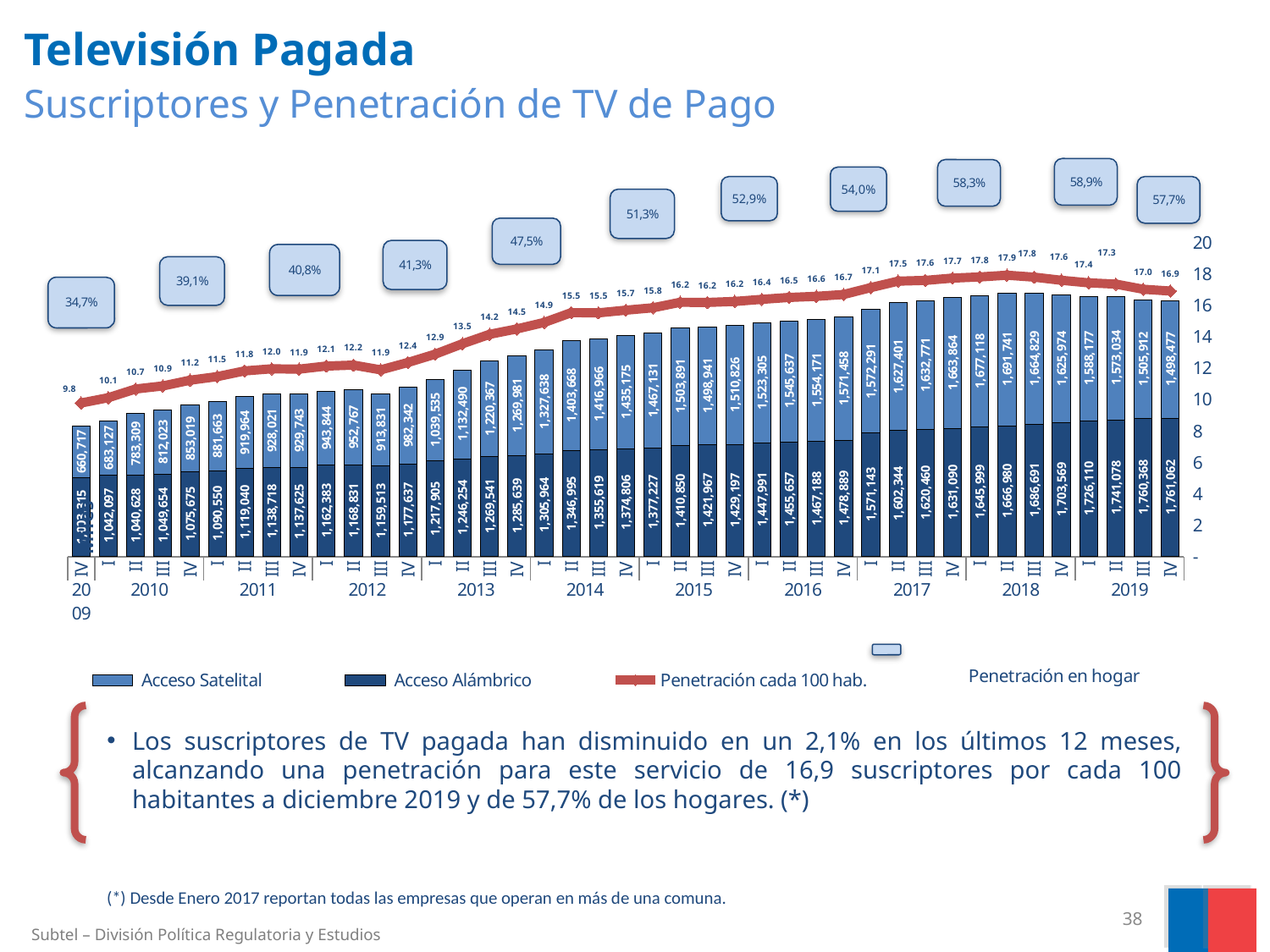
Which year has the highest Penetración en hogar? 2018 In IV 2019, which is larger: Acceso Alámbrico or Acceso Satelital? Acceso Alámbrico What is the Acceso Alámbrico value for IV 2019? 1,761,062 What is the value of Penetración cada 100 hab. for IV 2019? 16.9 What kind of chart is shown on the slide? Stacked bar chart with a line What is the Penetración en hogar shown for 2019? 57,7% What is the lowest Penetración en hogar value shown? 34,7% What is the Acceso Satelital value for IV 2019? 1,498,477 What is the Penetración en hogar shown for 2013? 47,5% What is the total of the stacked bar for IV 2019 (Acceso Alámbrico plus Acceso Satelital)? 3,259,539 What is the difference between the Penetración en hogar for 2018 and 2019? 1,2 percentage points What is the highest value reached by the Penetración cada 100 hab. line? 17.9